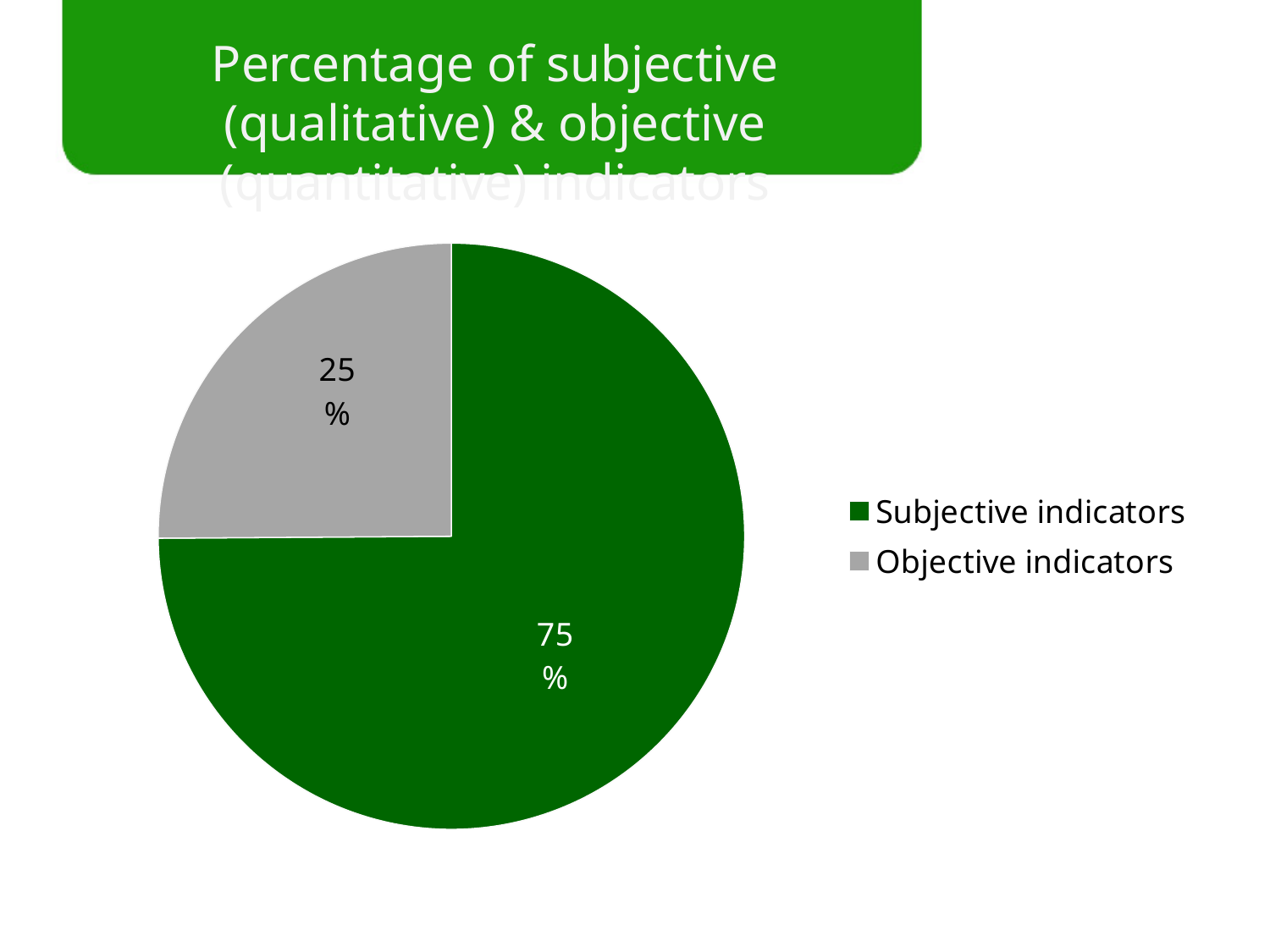
What percentage of the pie is Subjective indicators? 75% Which slice of the pie is the smallest? Objective indicators What colour is the Subjective indicators slice? green How many slices does the pie chart have? 2 Which is larger, the Subjective indicators slice or the Objective indicators slice? Subjective indicators What is the difference in percentage points between Subjective indicators and Objective indicators? 50 What kind of chart is shown on the slide? pie chart What colour is the Objective indicators slice? grey Which slice of the pie is the largest? Subjective indicators What percentage of the pie is Objective indicators? 25% How many entries does the legend list? 2